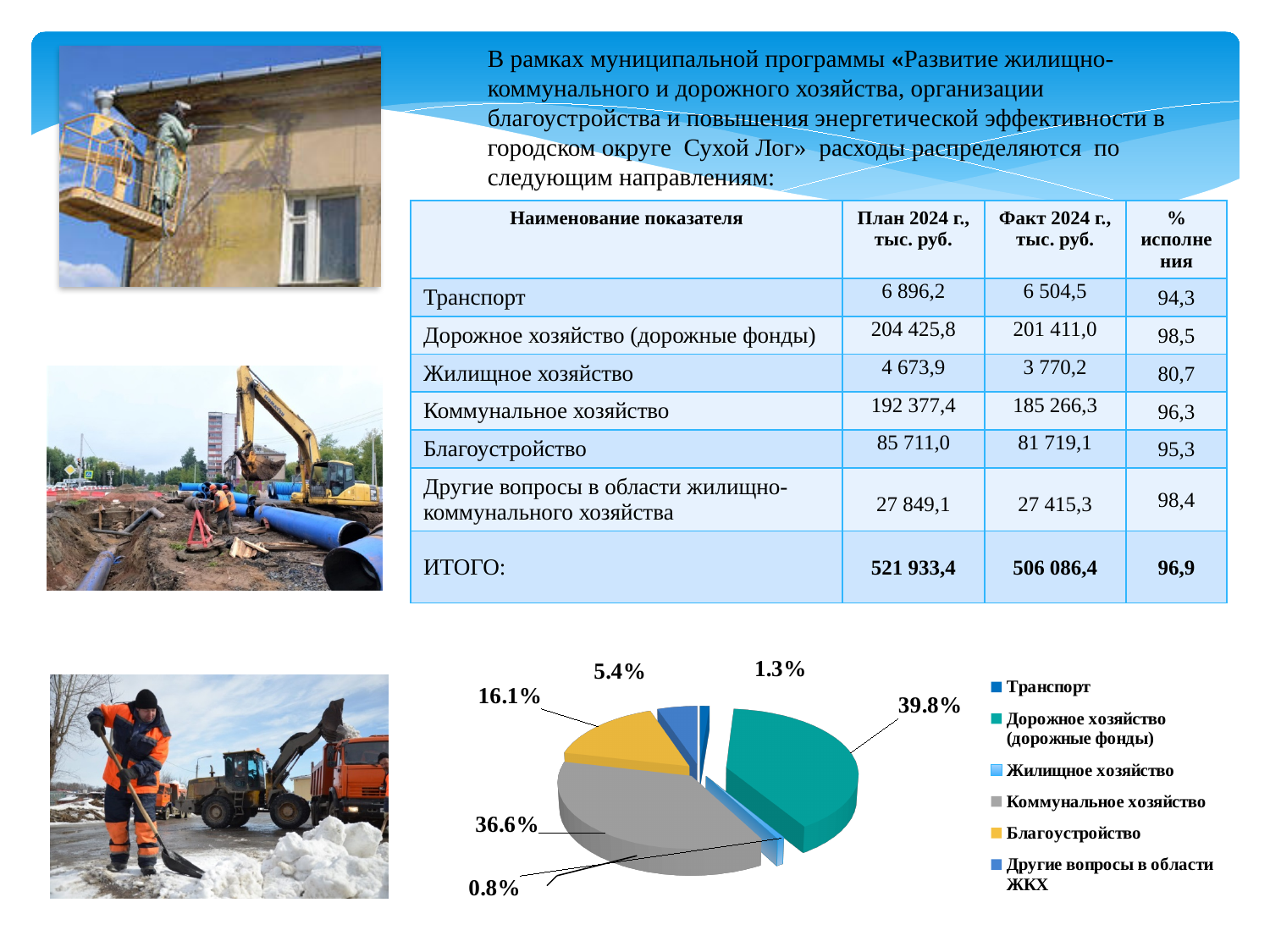
Which category has the largest slice in the pie chart? Дорожное хозяйство (дорожные фонды) In the pie chart, what is the difference between the shares for Дорожное хозяйство (дорожные фонды) and Коммунальное хозяйство? 3.2% How many categories does the pie chart legend list? 6 In the pie chart, what share is shown for Благоустройство? 16.1% What kind of chart is shown at the bottom of the slide? pie chart In the pie chart, what share is shown for Жилищное хозяйство? 0.8% In the pie chart, what share is shown for Другие вопросы в области ЖКХ? 5.4% In the pie chart, which is larger: the share for Благоустройство or the share for Другие вопросы в области ЖКХ? Благоустройство Which category has the smallest slice in the pie chart? Жилищное хозяйство